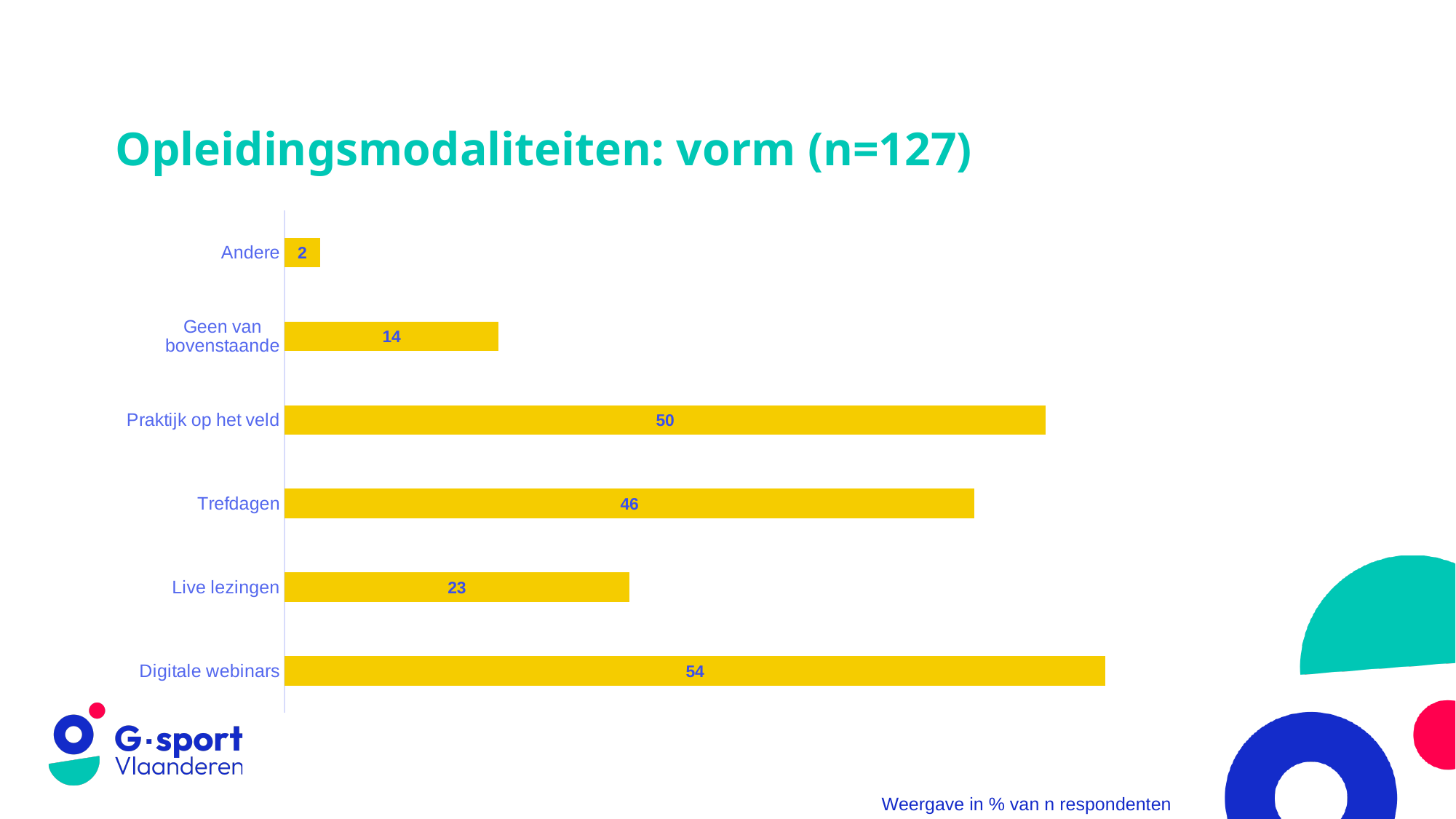
What is the value for Geen van bovenstaande? 14 What is the value for Praktijk op het veld? 50 How many categories are shown in the chart? 6 What is the title of the chart on the slide? Opleidingsmodaliteiten: vorm (n=127) What kind of chart is shown on the slide? Bar chart Which category has the lowest value? Andere What is the value for Live lezingen? 23 What is the difference between the values for Digitale webinars and Trefdagen? 8 Which is larger, the value for Trefdagen or the value for Live lezingen? Trefdagen Which category has the highest value? Digitale webinars What is the value for Digitale webinars? 54 What is the difference between the values for Praktijk op het veld and Live lezingen? 27